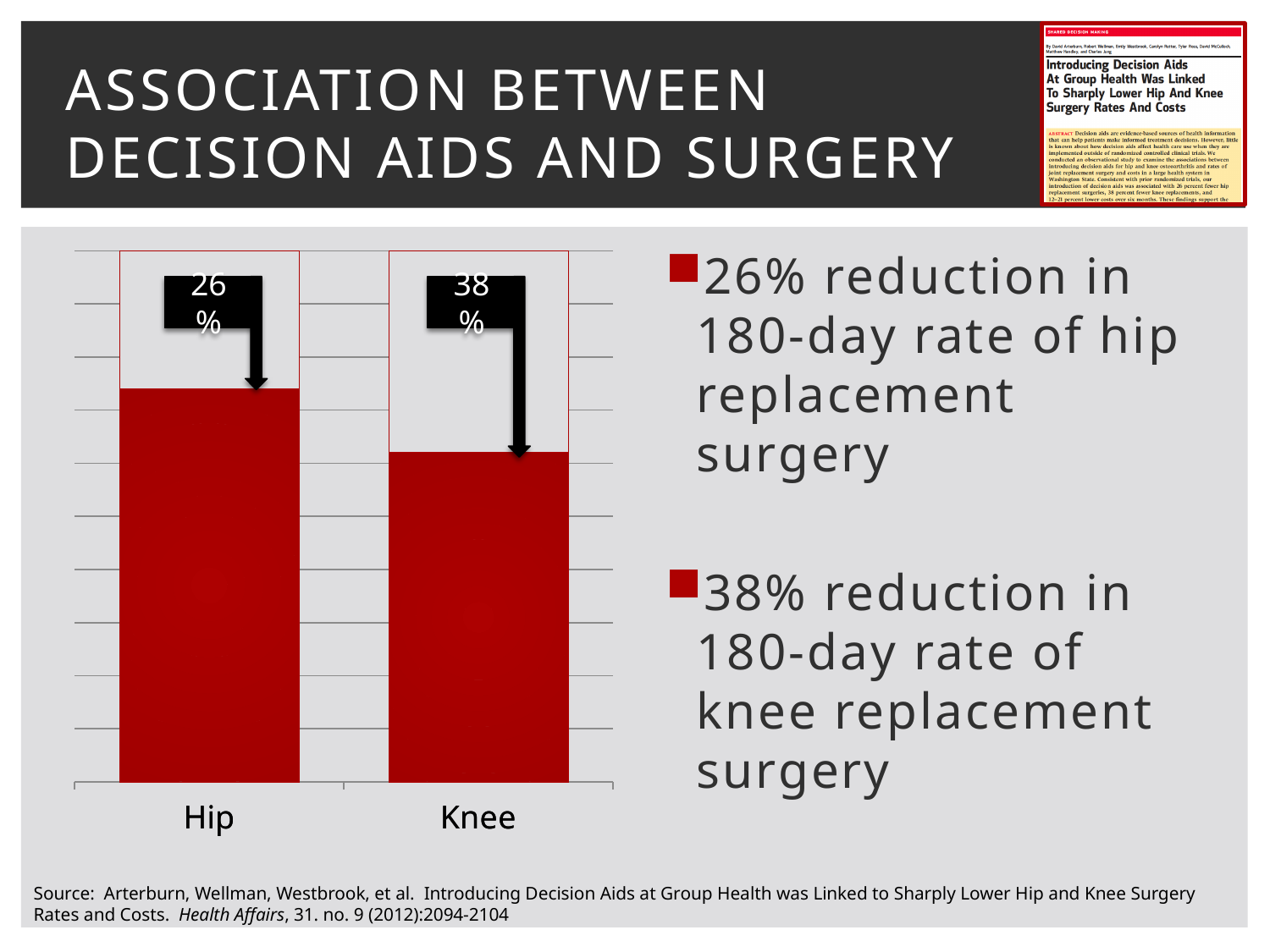
What are the two category labels on the x axis of the chart? Hip and Knee Which category shows the smaller labeled percentage reduction? Hip Which category has the taller red bar, Hip or Knee? Hip What is the difference between the labeled reduction for Knee and the labeled reduction for Hip? 12 percentage points What kind of chart is shown on the slide? bar chart How many categories are shown on the x axis of the chart? 2 What colour are the bars in the chart? red What percentage reduction is labeled above the Hip bar? 26% Which category has the shorter red bar? Knee What percentage reduction is labeled above the Knee bar? 38% Which category shows the larger labeled percentage reduction? Knee